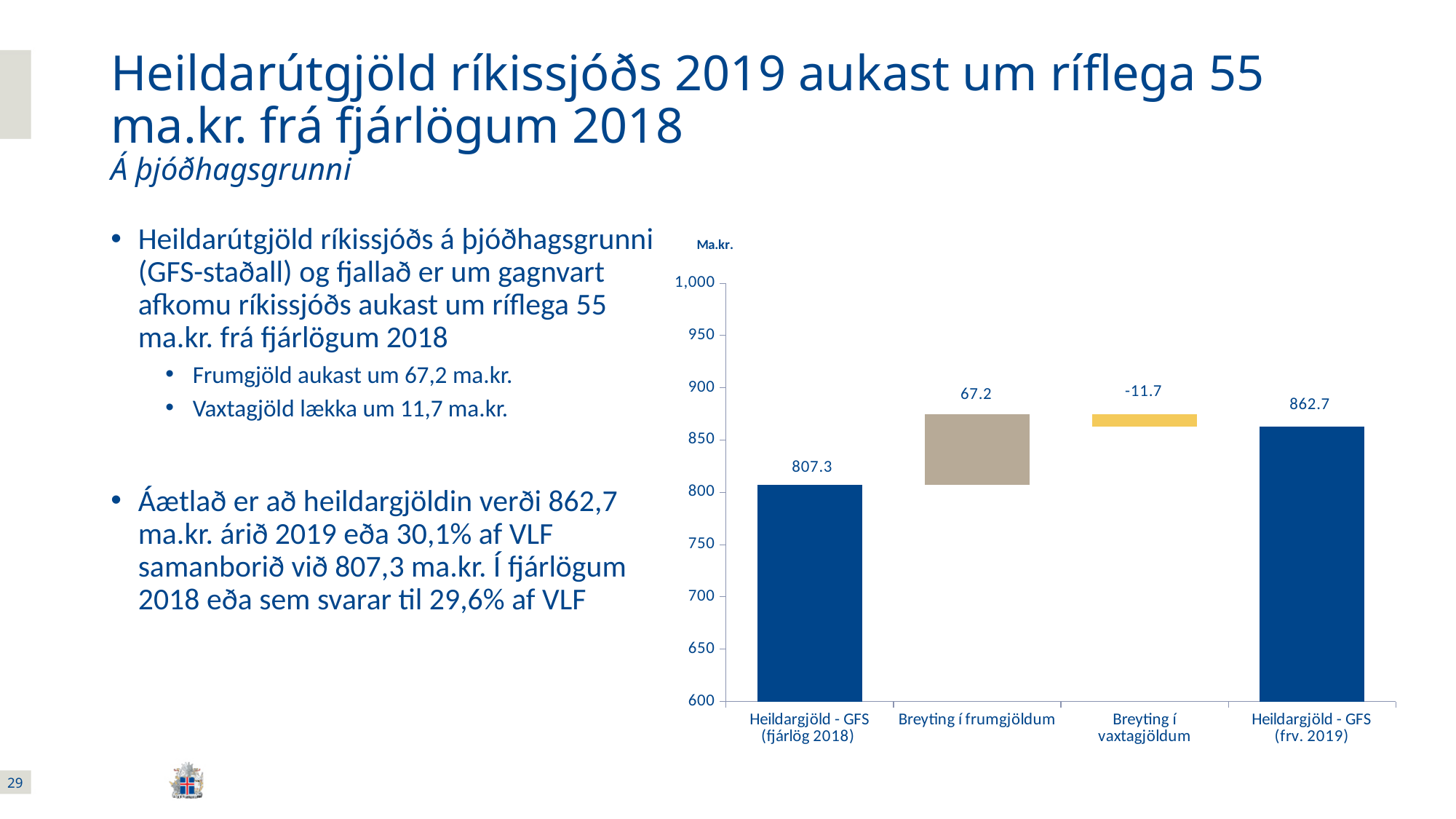
Which is larger, the value for Heildargjöld - GFS (frv. 2019) or the value for Heildargjöld - GFS (fjárlög 2018)? Heildargjöld - GFS (frv. 2019) What is the value shown for Heildargjöld - GFS (fjárlög 2018)? 807.3 Which category has the lowest labelled value? Breyting í vaxtagjöldum What is the value labelled on the Breyting í vaxtagjöldum bar? -11.7 What is the value labelled on the Breyting í frumgjöldum bar? 67.2 Which category has the highest labelled value? Heildargjöld - GFS (frv. 2019) What unit is shown above the vertical axis of the chart? Ma.kr. What is the difference between the Heildargjöld - GFS (frv. 2019) value and the Heildargjöld - GFS (fjárlög 2018) value? 55.4 What kind of chart is shown on the slide? bar chart What is the value shown for Heildargjöld - GFS (frv. 2019)? 862.7 How many categories are shown on the x axis of the chart? 4 Is the value for Heildargjöld - GFS (fjárlög 2018) greater or less than 850? less